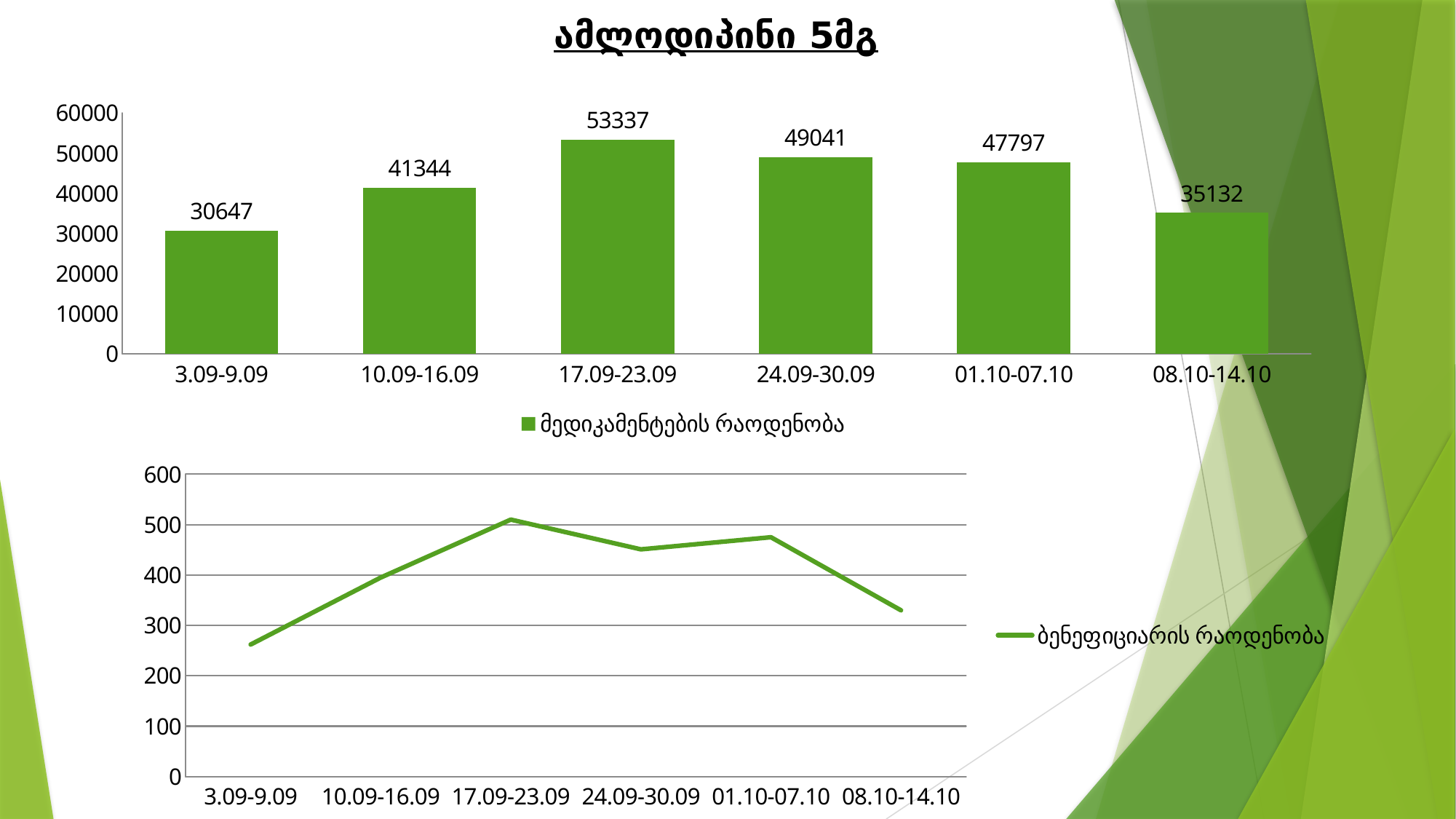
In the bottom line chart, is the value for 3.09-9.09 greater or less than 300? less How many bars are in the top bar chart? 6 What type of chart is the top chart on the slide? bar chart In the bottom line chart, is the value for 17.09-23.09 greater or less than 500? greater In the top bar chart, which period has the lowest value? 3.09-9.09 In the top bar chart, what is the difference between the values for 24.09-30.09 and 01.10-07.10? 1244 What is the title of the top bar chart? ამლოდიპინი 5მგ In the top bar chart, which is larger: the value for 10.09-16.09 or the value for 08.10-14.10? 10.09-16.09 What type of chart is the bottom chart on the slide? line chart In the top bar chart, which period has the highest value? 17.09-23.09 In the top bar chart, what is the value for 3.09-9.09? 30647 In the top bar chart, what is the value for 17.09-23.09? 53337